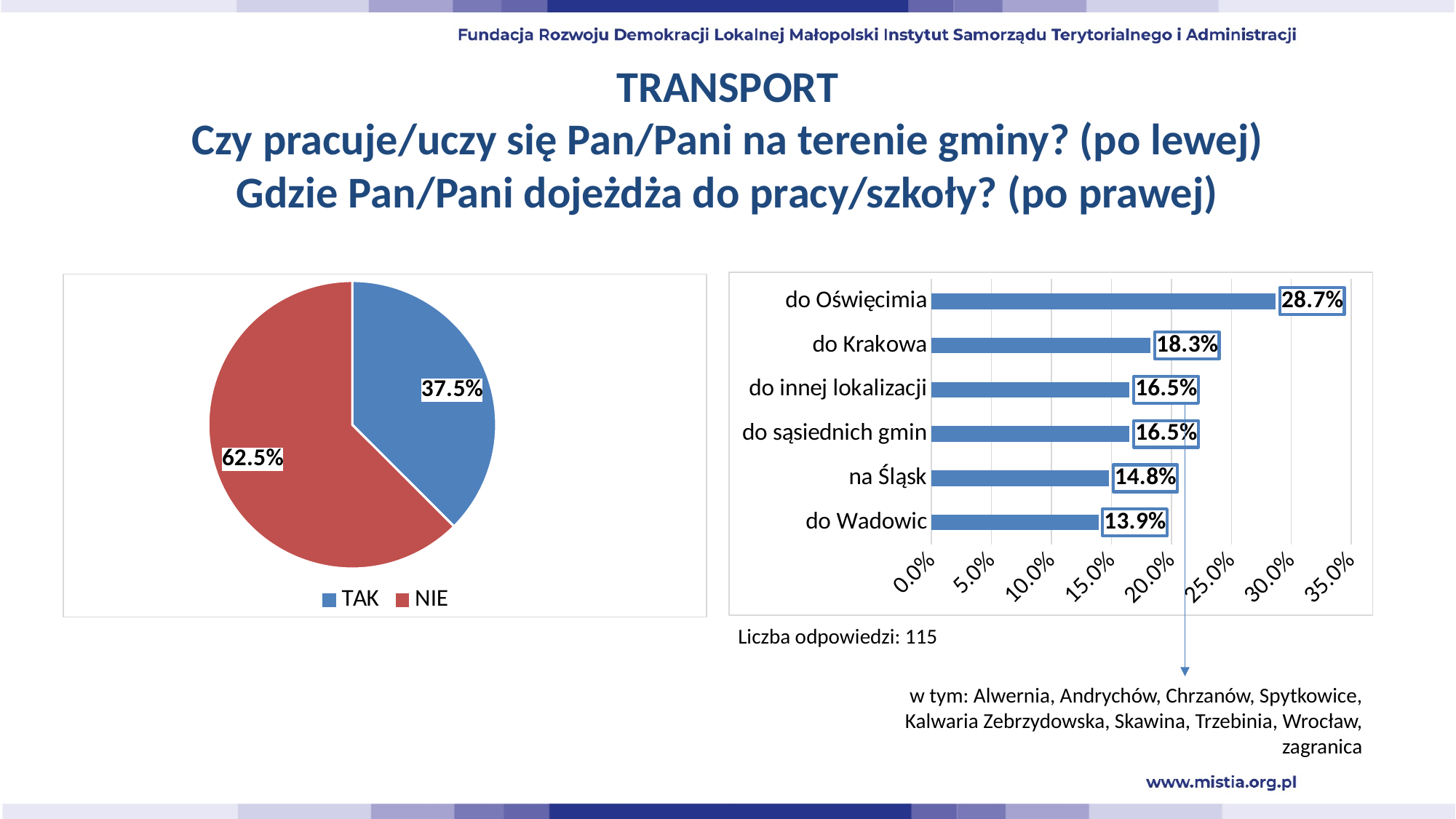
In the pie chart on the left, what share of respondents answered NIE? 62.5% How many entries does the legend of the pie chart on the left list? 2 How many categories are shown in the bar chart on the right? 6 In the bar chart on the right, what is the value for 'do Krakowa'? 18.3% In the bar chart on the right, which category has the lowest value? do Wadowic What type of chart is shown on the right side of the slide? bar chart In the pie chart on the left, what share of respondents answered TAK? 37.5% In the pie chart on the left, which answer has the larger share, TAK or NIE? NIE In the bar chart on the right, which category has the highest value? do Oświęcimia What type of chart is shown on the left side of the slide? pie chart In the bar chart on the right, what is the difference between 'do Oświęcimia' and 'na Śląsk'? 13.9% In the pie chart on the left, what is the difference between the NIE and TAK shares? 25.0%